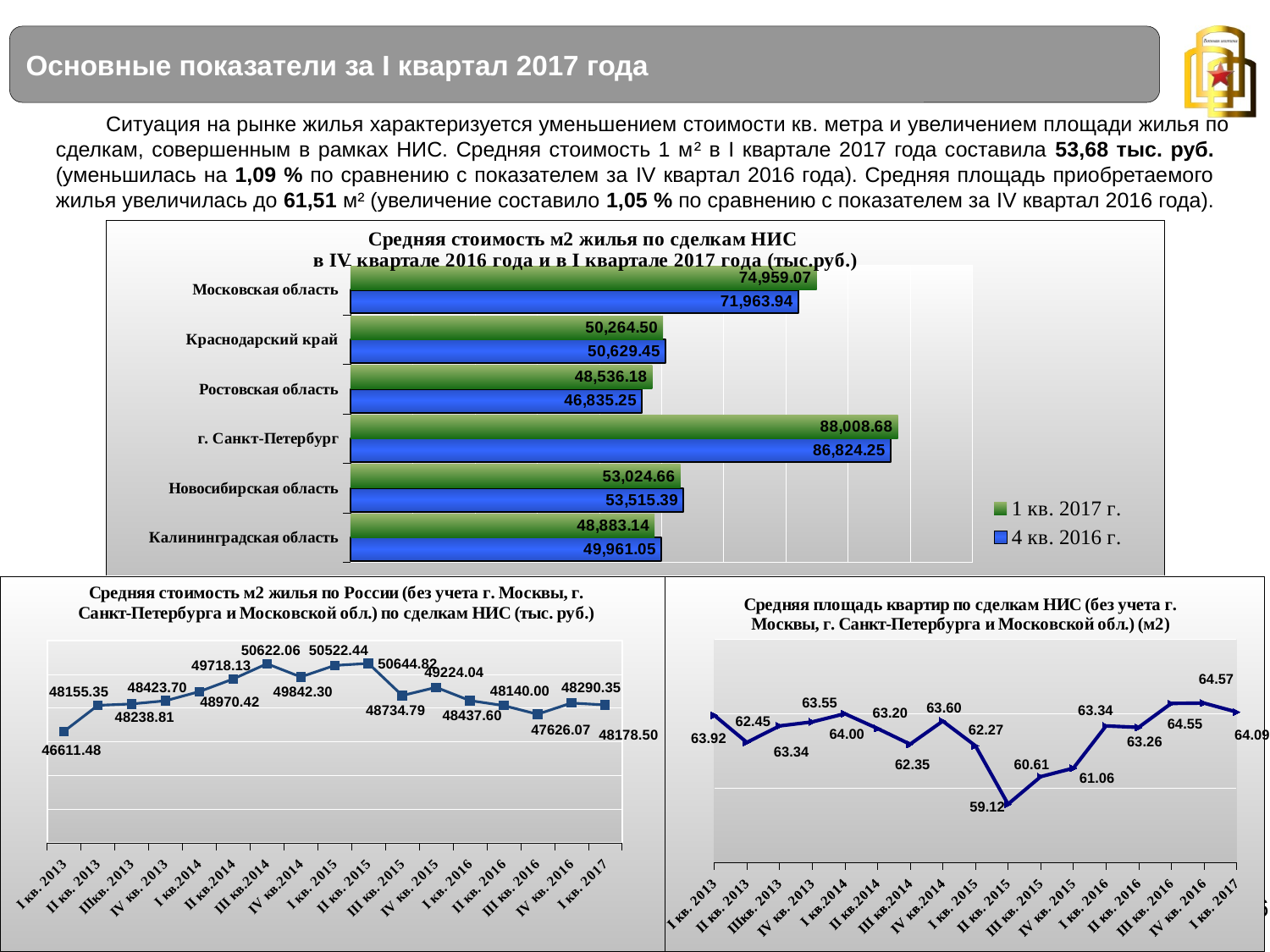
In the bottom-left chart 'Средняя стоимость м2 жилья по России', what is the value for I кв. 2017? 48178.50 In the top chart 'Средняя стоимость м2 жилья по сделкам НИС', which region has the lowest value in the '4 кв. 2016 г.' series? Ростовская область In the top chart 'Средняя стоимость м2 жилья по сделкам НИС', what is the value for г. Санкт-Петербург in the '1 кв. 2017 г.' series? 88,008.68 In the bottom-left chart 'Средняя стоимость м2 жилья по России', which quarter has the lowest value? I кв. 2013 In the bottom-right chart 'Средняя площадь квартир по сделкам НИС', which quarter has the lowest value? II кв. 2015 In the top chart 'Средняя стоимость м2 жилья по сделкам НИС', which region has the highest value in the '1 кв. 2017 г.' series? г. Санкт-Петербург In the top chart 'Средняя стоимость м2 жилья по сделкам НИС', how many series does the legend list? 2 What type of chart is the top chart 'Средняя стоимость м2 жилья по сделкам НИС'? Bar chart In the bottom-left chart 'Средняя стоимость м2 жилья по России', how many data points are plotted? 17 In the bottom-right chart 'Средняя площадь квартир по сделкам НИС', is the value for IV кв. 2016 larger or smaller than the value for I кв. 2017? Larger In the top chart 'Средняя стоимость м2 жилья по сделкам НИС', what is the value for Ростовская область in the '4 кв. 2016 г.' series? 46,835.25 In the top chart 'Средняя стоимость м2 жилья по сделкам НИС', what is the difference between the '1 кв. 2017 г.' and '4 кв. 2016 г.' values for Московская область? 2,995.13